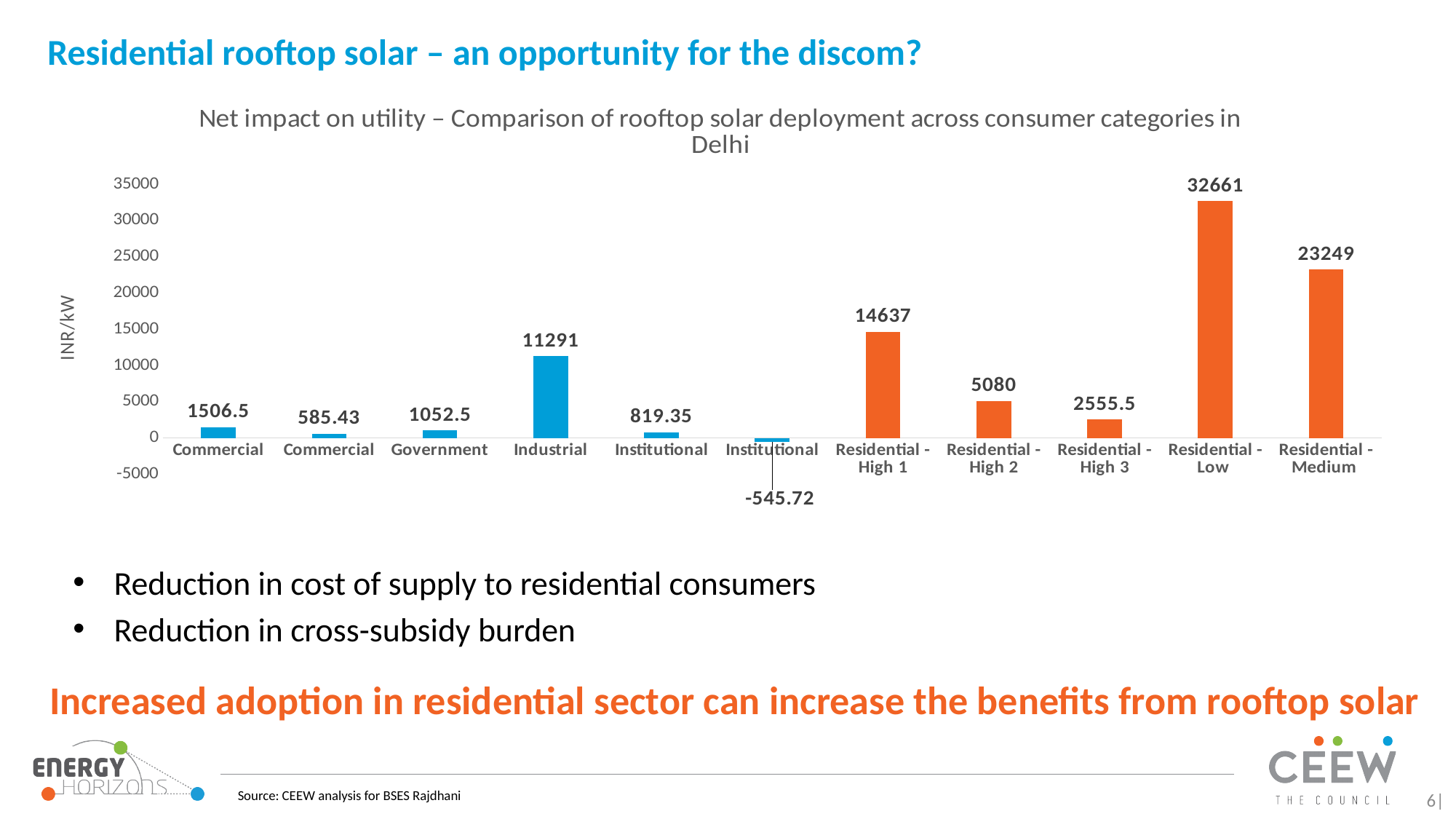
Is the value for Residential - Medium greater or less than 20000? greater What is the value for Residential - Low? 32661 What is the difference between the values for Residential - High 1 and Residential - High 2? 9557 How many bars are plotted in the chart? 11 Which is larger, the value for Residential - High 1 or the value for Industrial? Residential - High 1 Which consumer category has the highest net impact on utility? Residential - Low What is the value for Government? 1052.5 What is the value for Residential - High 2? 5080 Which consumer category has the lowest (negative) net impact on utility? Institutional What is the label on the vertical axis of the chart? INR/kW What is the difference between the values for Residential - Low and Residential - Medium? 9412 What is the value for Industrial? 11291